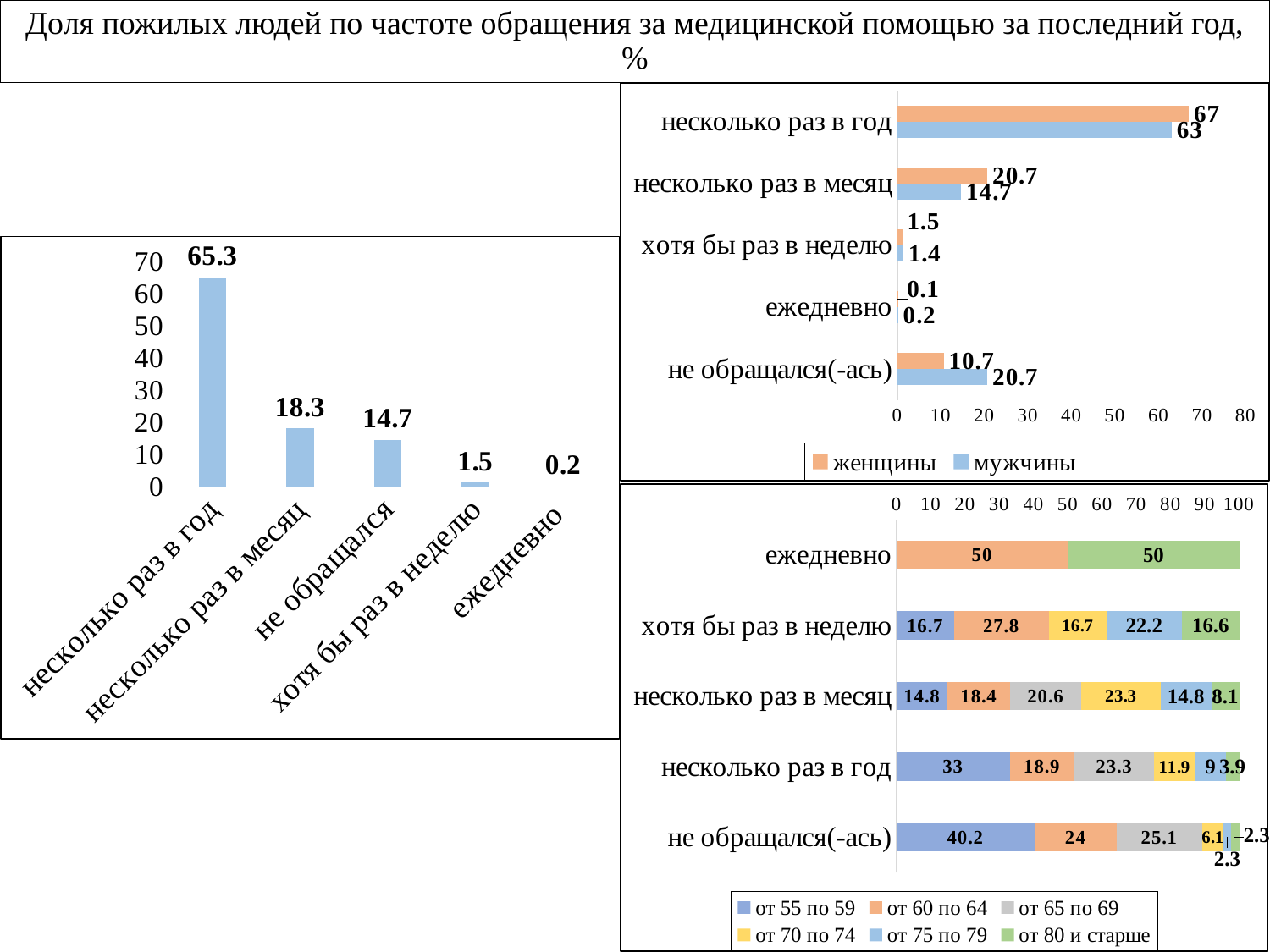
In the bar chart on the left, which category has the highest value? несколько раз в год In the top-right chart, what is the value for 'мужчины' in the category 'несколько раз в месяц'? 14.7 How many series does the legend of the top-right chart list? 2 In the bar chart on the left, what is the value for 'несколько раз в месяц'? 18.3 In the bottom-right stacked chart, what is the value for 'от 55 по 59' in the category 'не обращался(-ась)'? 40.2 In the top-right chart, for 'несколько раз в год', which is larger: 'женщины' or 'мужчины'? женщины How many categories are shown in the top-right chart? 5 In the top-right chart, what is the difference between 'мужчины' and 'женщины' for 'не обращался(-ась)'? 10 How many series does the legend of the bottom-right stacked chart list? 6 What kind of chart is the chart on the left of the slide? bar chart In the bar chart on the left, which category has the lowest value? ежедневно In the bottom-right stacked chart, what is the total of the bar for 'ежедневно'? 100